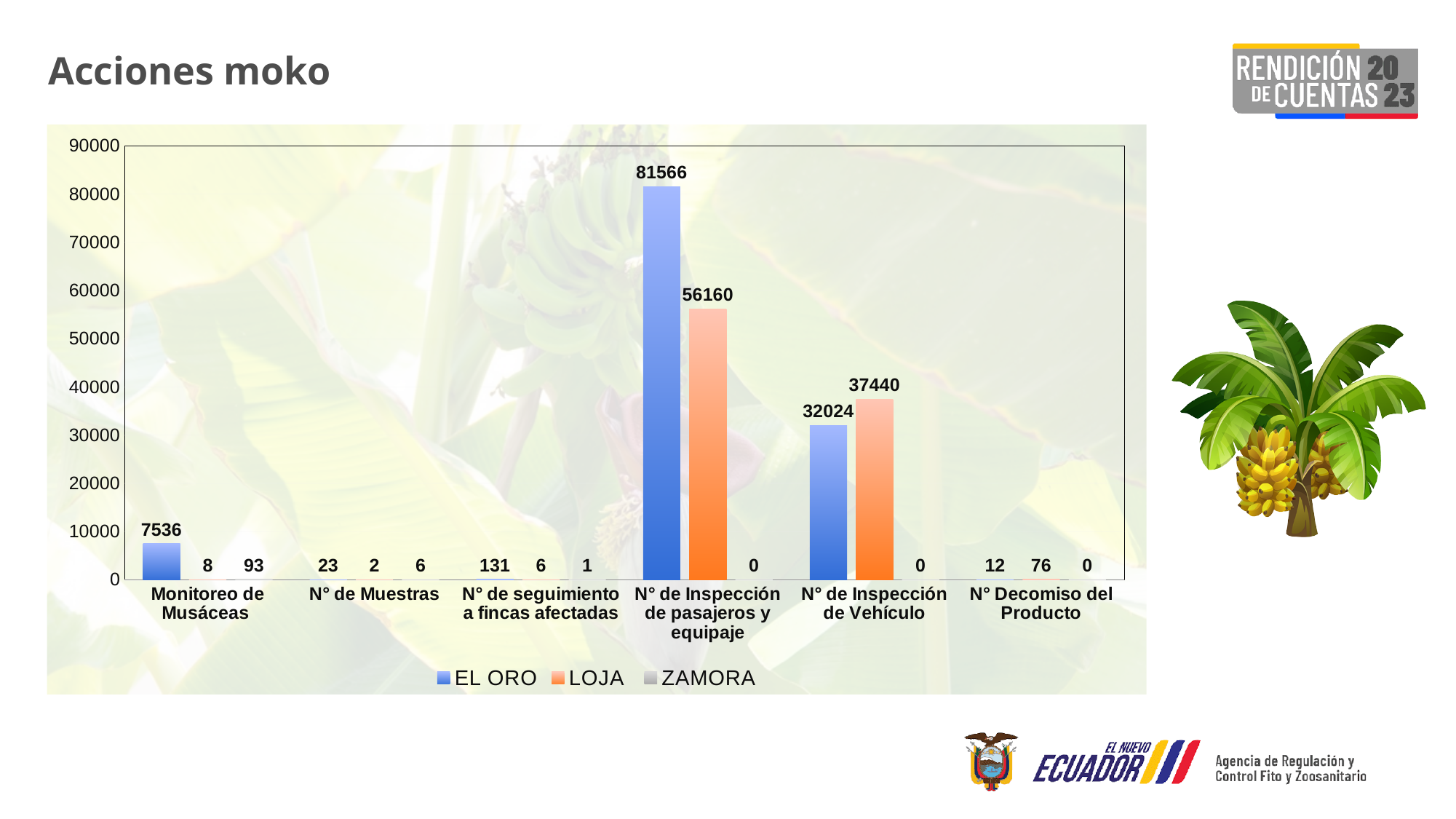
Is the value for EL ORO in N° de Inspección de pasajeros y equipaje greater or less than 80000? greater What is the value for EL ORO in the category N° de Inspección de pasajeros y equipaje? 81566 How many categories are shown on the x axis of the chart? 6 What is the difference between the LOJA and EL ORO values in the category N° de Inspección de Vehículo? 5416 What kind of chart is shown on the slide? bar chart Which category has the highest value for EL ORO? N° de Inspección de pasajeros y equipaje What is the value for EL ORO in the category N° de seguimiento a fincas afectadas? 131 How many series does the legend list? 3 What is the value for ZAMORA in the category Monitoreo de Musáceas? 93 What is the value for LOJA in the category N° de Inspección de Vehículo? 37440 In the category N° de Inspección de Vehículo, which series has the larger value, EL ORO or LOJA? LOJA What is the difference between the EL ORO and LOJA values in the category N° de Inspección de pasajeros y equipaje? 25406